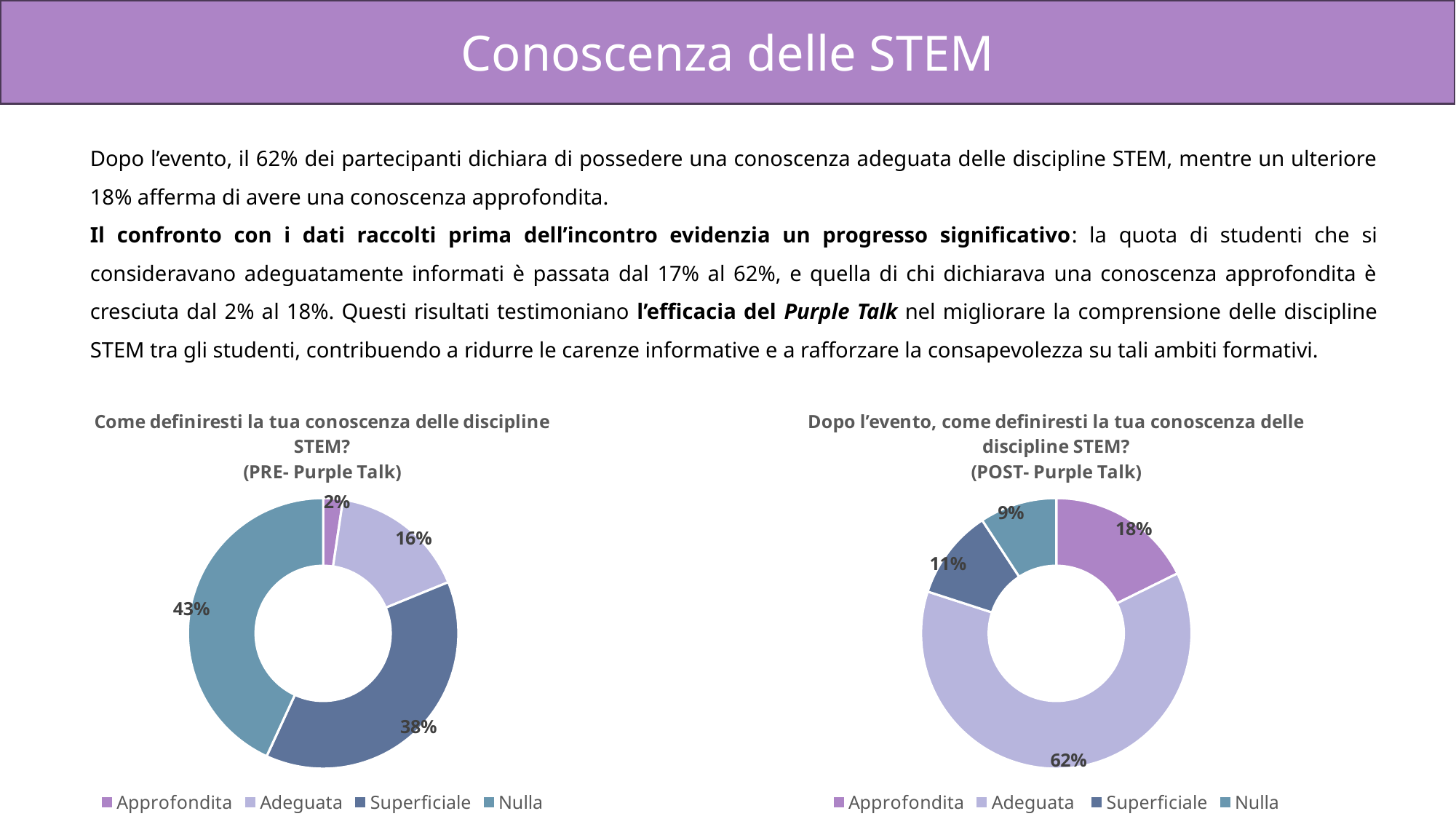
In the PRE-Purple Talk chart, what colour is the "Nulla" slice? Teal In the PRE-Purple Talk chart, which is larger: the share for "Superficiale" or the share for "Adeguata"? Superficiale In the POST-Purple Talk chart, what percentage of respondents chose "Superficiale"? 11% In the POST-Purple Talk chart, which category has the smallest share? Nulla In the PRE-Purple Talk chart, what percentage of respondents chose "Approfondita"? 2% In the POST-Purple Talk chart, what percentage of respondents chose "Adeguata"? 62% What is the difference between the "Adeguata" share in the POST-Purple Talk chart and the "Adeguata" share in the PRE-Purple Talk chart? 46 percentage points What type of chart is the PRE-Purple Talk chart? Doughnut (pie) chart In the POST-Purple Talk chart, which category has the largest share? Adeguata In the PRE-Purple Talk chart, which category has the largest share? Nulla In the PRE-Purple Talk chart, what percentage of respondents chose "Nulla"? 43% How many categories does the legend of the POST-Purple Talk chart list? 4